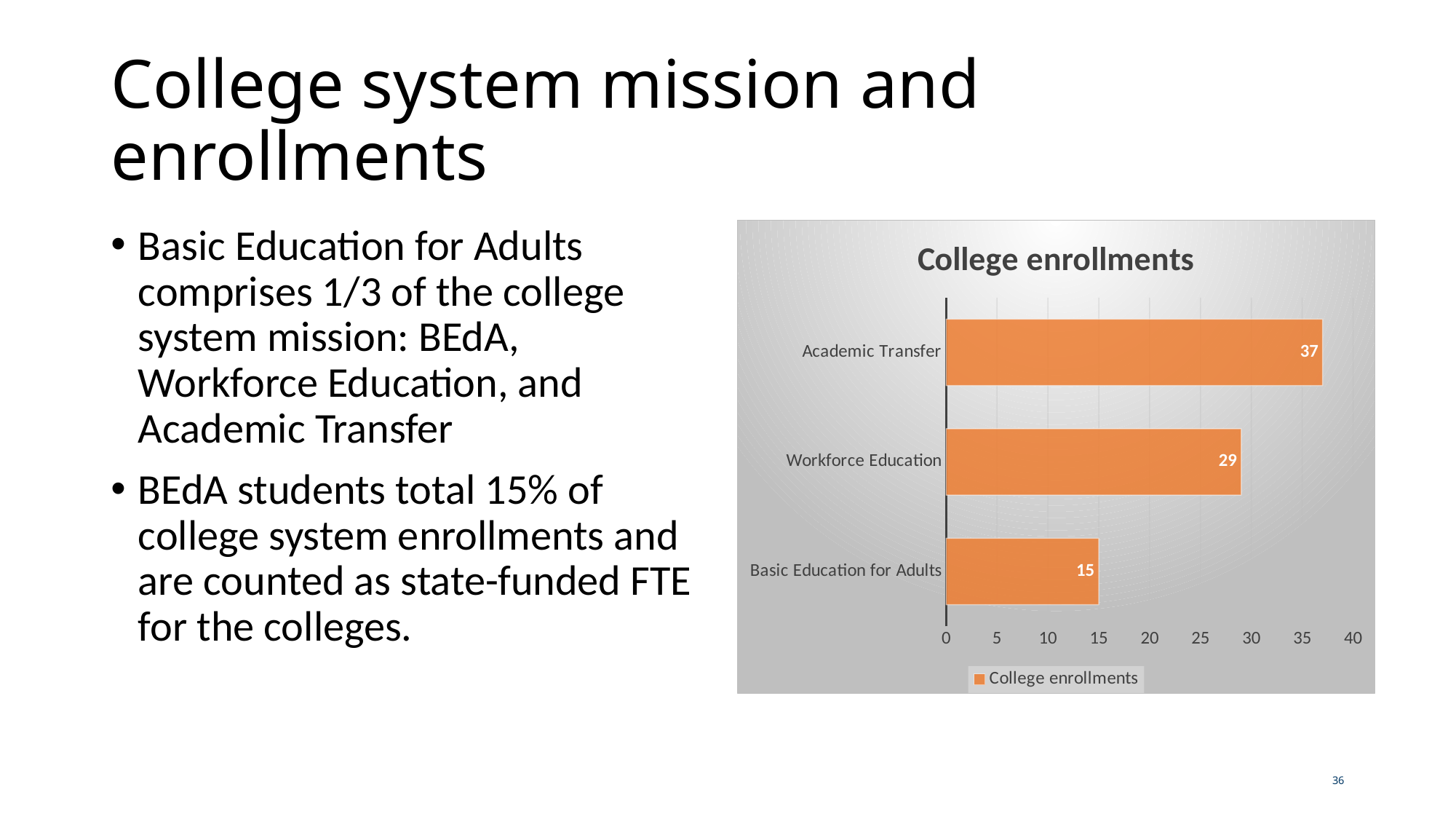
What is the value for Workforce Education in the College enrollments chart? 29 Which is larger, the value for Workforce Education or the value for Basic Education for Adults? Workforce Education Is the value for Academic Transfer greater or less than 35? greater How many series does the legend of the College enrollments chart list? 1 What is the value for Basic Education for Adults in the College enrollments chart? 15 What is the value for Academic Transfer in the College enrollments chart? 37 Which category has the highest value in the College enrollments chart? Academic Transfer What kind of chart is the College enrollments chart? Bar chart How many categories are shown in the College enrollments chart? 3 What is the difference between the values for Workforce Education and Basic Education for Adults? 14 What is the difference between the values for Academic Transfer and Workforce Education? 8 Which category has the lowest value in the College enrollments chart? Basic Education for Adults